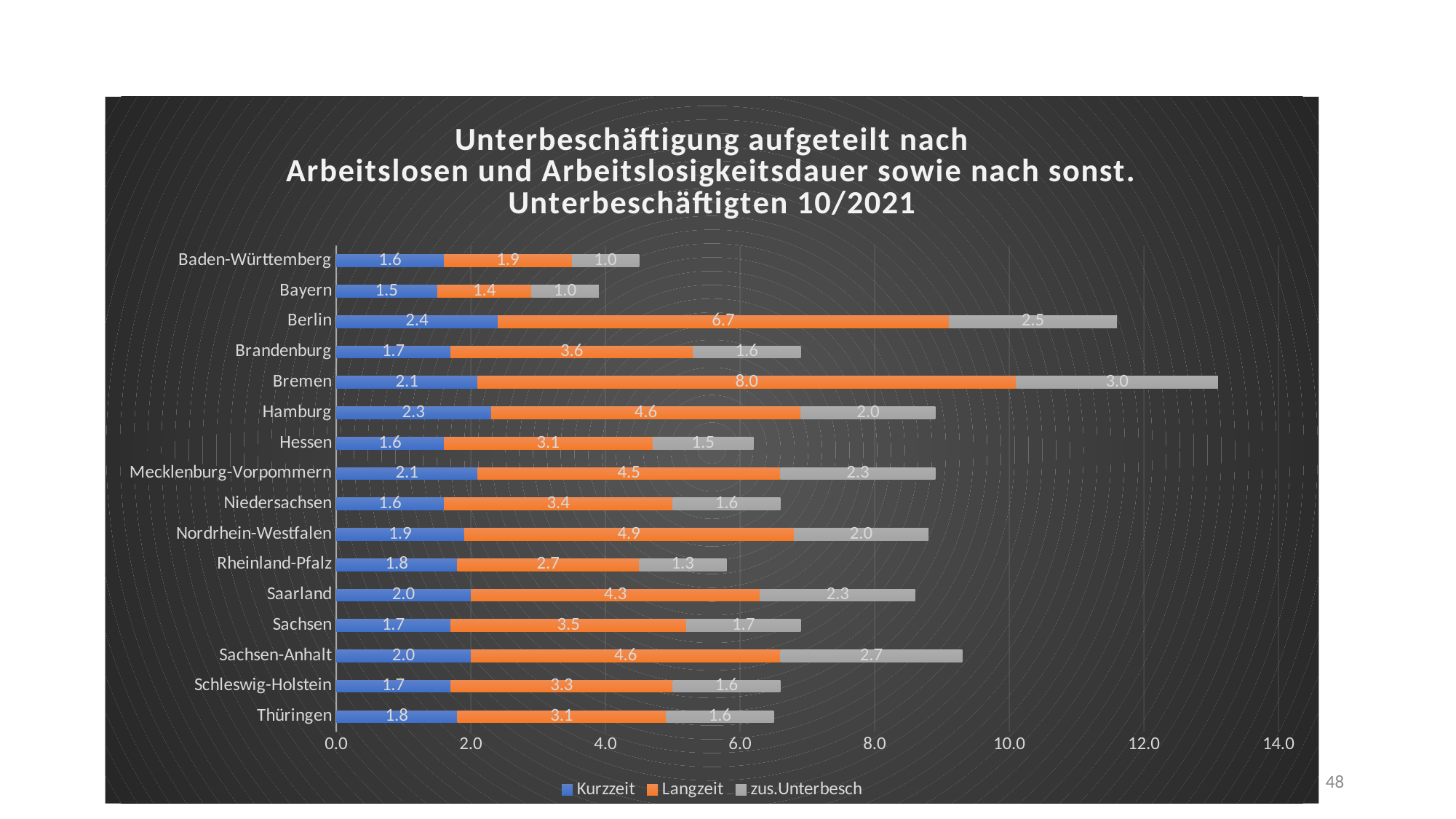
How many series does the legend list? 3 What kind of chart is shown on the slide? Stacked bar chart How many states are shown on the chart? 16 Which state has the highest Langzeit value? Bremen Which state has the lowest Langzeit value? Bayern What is the total of the stacked bar for Bayern? 3.9 What is the total of the stacked bar for Bremen? 13.1 What is the Kurzzeit value for Berlin? 2.4 Which is larger, the Langzeit value for Nordrhein-Westfalen or for Saarland? Nordrhein-Westfalen What is the Langzeit value for Bremen? 8.0 What is the zus.Unterbesch value for Sachsen-Anhalt? 2.7 What is the difference between the Langzeit values of Berlin and Hamburg? 2.1